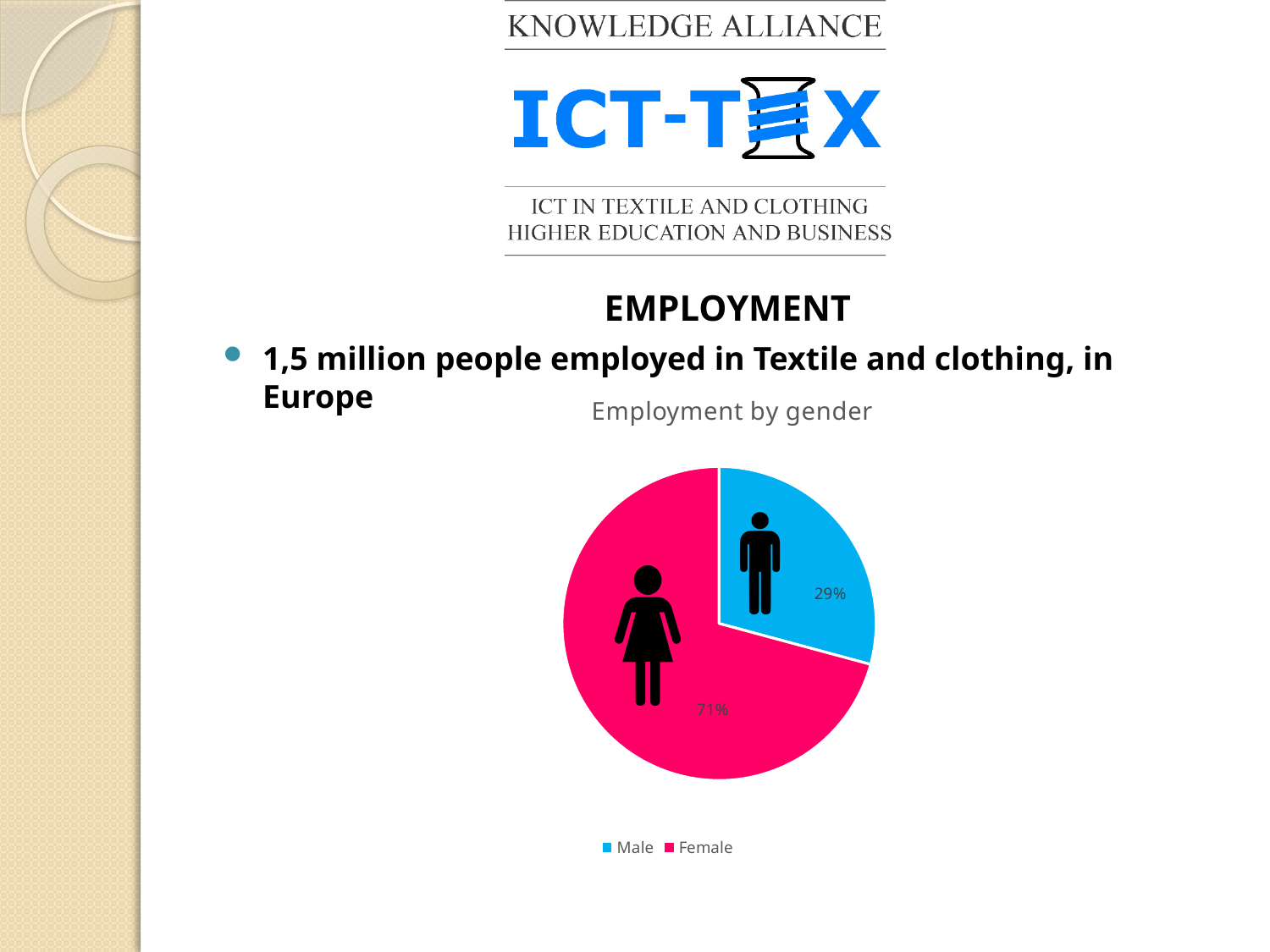
Which is larger, the Male slice or the Female slice? Female What is the difference in percentage points between the Female and Male slices? 42 What share of the pie does Female represent? 71% Which category has the smallest slice of the pie? Male How many entries does the legend list? 2 What is the title of the chart? Employment by gender What colour is the Female slice? pink What share of the pie does Male represent? 29% How many slices does the pie chart have? 2 What kind of chart is shown on the slide? pie chart Which category has the largest slice of the pie? Female